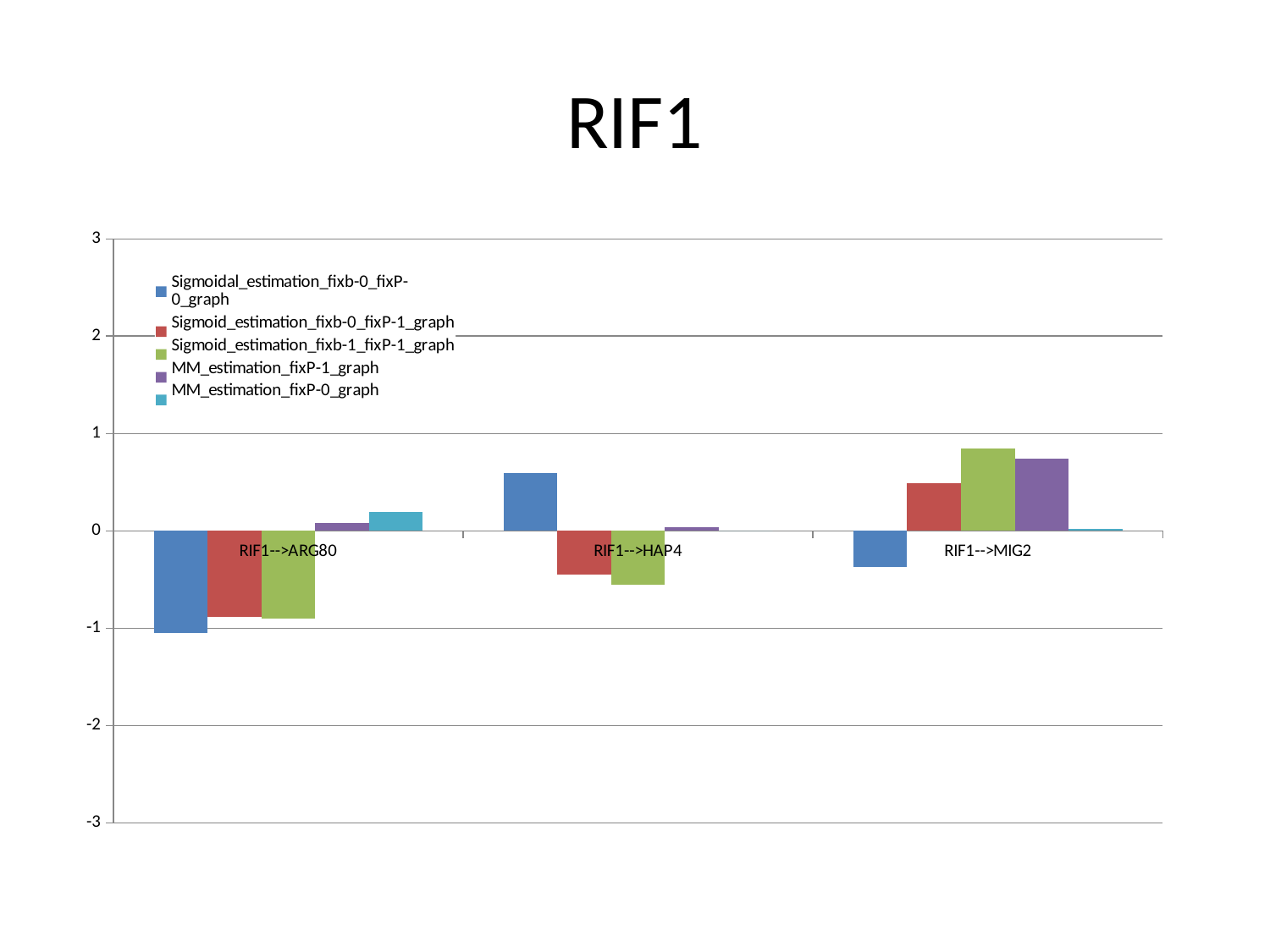
Is the value of Sigmoid_estimation_fixb-1_fixP-1_graph for RIF1-->MIG2 greater or less than 1? less Is the value of Sigmoid_estimation_fixb-1_fixP-1_graph for RIF1-->MIG2 greater or less than 0? greater How many categories are shown on the x axis? 3 What kind of chart is shown on the slide? bar chart Which series is shown in purple in the legend? MM_estimation_fixP-1_graph How many series does the legend list? 5 For Sigmoid_estimation_fixb-1_fixP-1_graph, which category has the highest value? RIF1-->MIG2 What is the title of the slide? RIF1 Is the value of Sigmoidal_estimation_fixb-0_fixP-0_graph for RIF1-->HAP4 greater or less than 1? less For RIF1-->MIG2, which is larger: Sigmoid_estimation_fixb-1_fixP-1_graph or Sigmoid_estimation_fixb-0_fixP-1_graph? Sigmoid_estimation_fixb-1_fixP-1_graph For Sigmoidal_estimation_fixb-0_fixP-0_graph, which category has the lowest value? RIF1-->ARG80